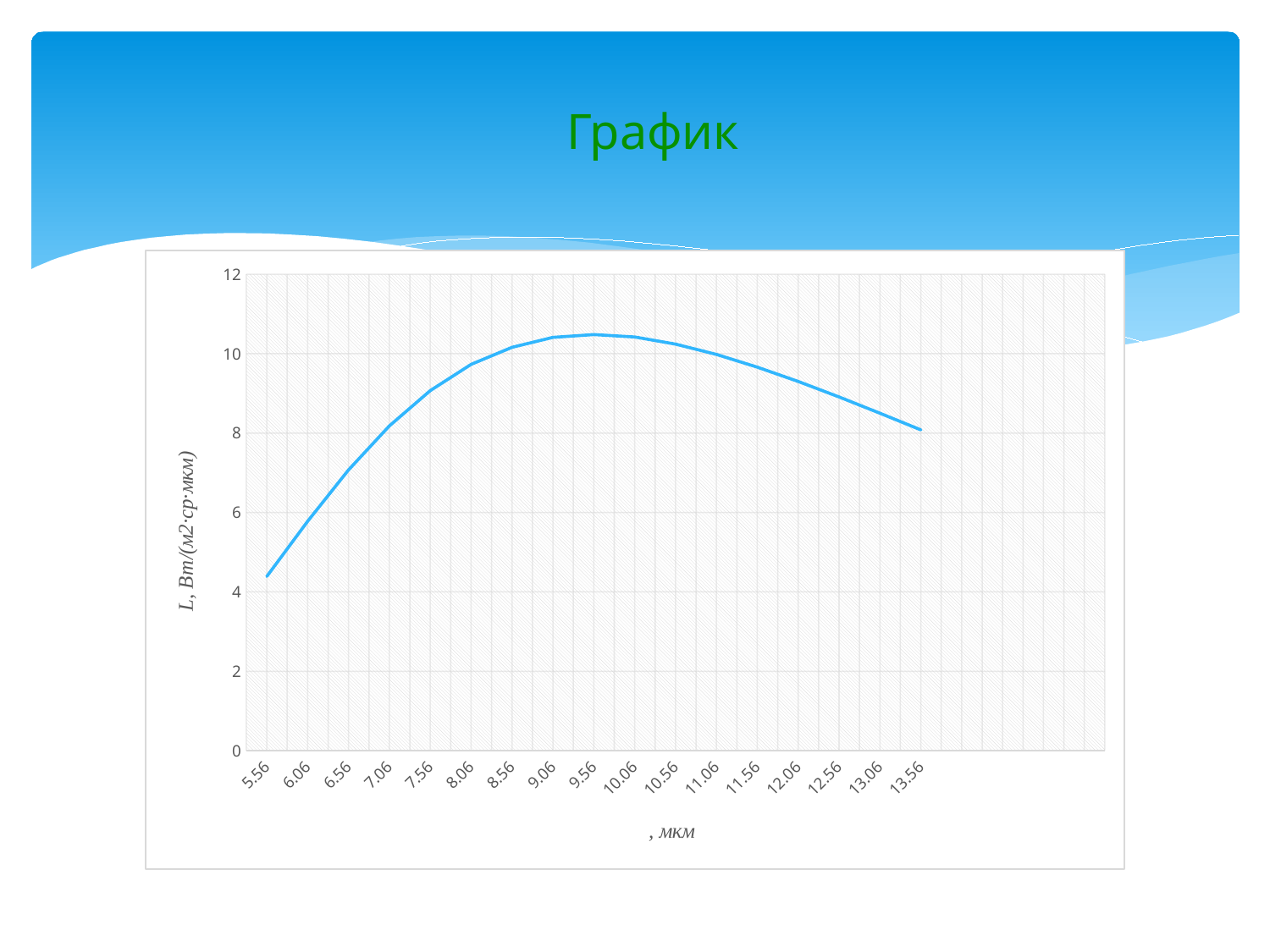
Does the plotted line rise or fall between 10.06 and 13.56? fall Is the value at 7.06 greater or less than 10? less At which x-axis value is the plotted line lowest? 5.56 How many tick labels are shown along the x axis of the chart? 17 Which has the larger value, 5.56 or 13.56? 13.56 What is the title of the chart? График Is the value at 5.56 greater or less than 4? greater Is the value at 9.56 greater or less than 10? greater What kind of chart is shown on the slide? line chart What is the label on the vertical axis of the chart? L, Вт/(м2·ср·мкм)